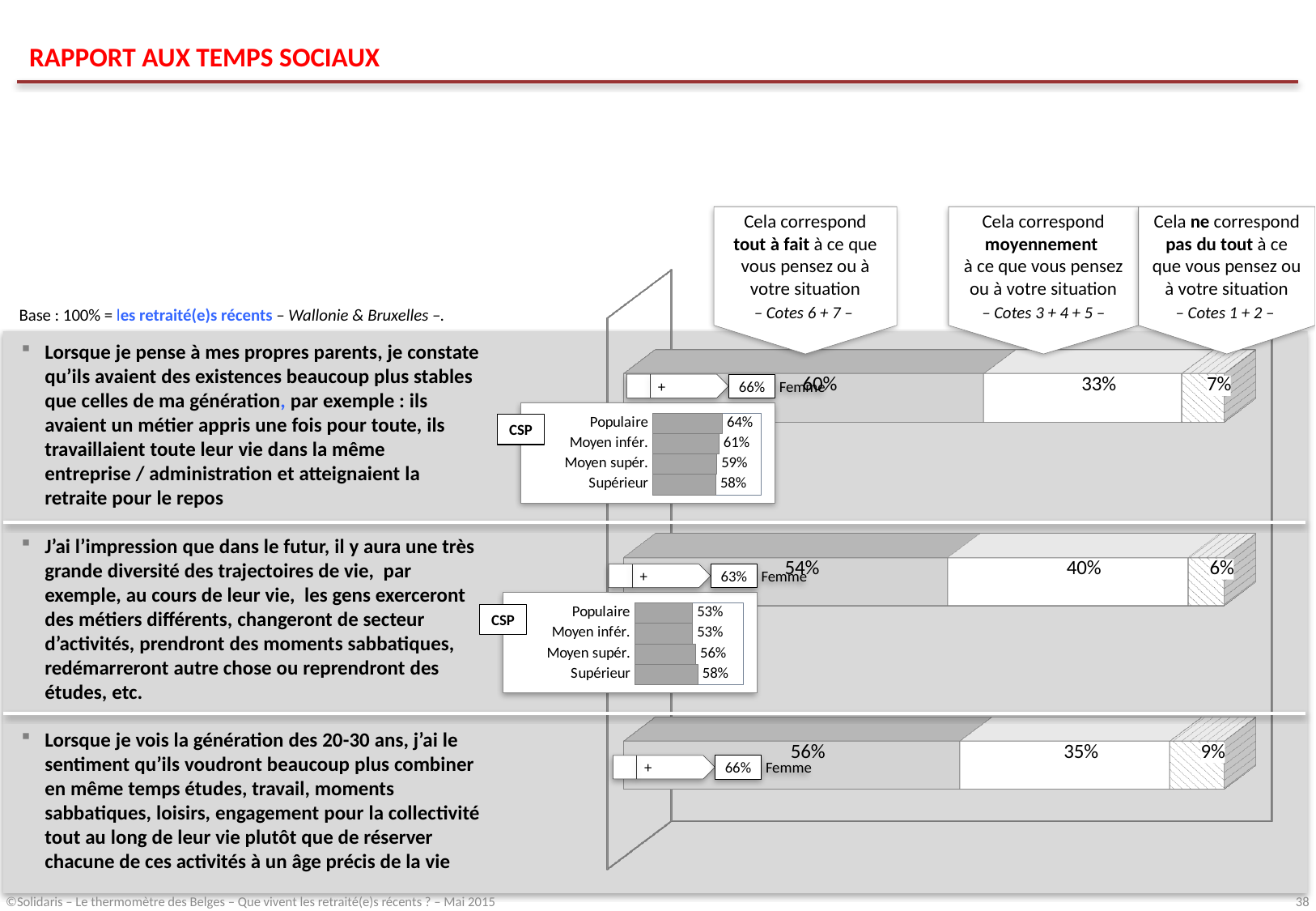
What is the 'Femme' value shown next to the bottom stacked bar (20-30 ans generation)? 66% Which of the three stacked bars has the largest 'Cela ne correspond pas du tout' share? The bottom bar (20-30 ans generation), 9% In the top stacked bar (about parents having more stable existences), what percentage corresponds to 'Cela correspond moyennement'? 33% In the middle stacked bar (about future diversity of life trajectories), what percentage corresponds to 'Cela correspond tout à fait'? 54% In the bottom stacked bar (about the 20-30 year old generation), what is the difference between the 'tout à fait' share and the 'moyennement' share? 21 percentage points In the top stacked bar (about parents having more stable existences), what percentage corresponds to 'Cela ne correspond pas du tout'? 7% In the CSP breakdown for the middle statement (future diversity of trajectories), what is the value for 'Supérieur'? 58% In the CSP breakdown for the middle statement, is the value for 'Moyen supér.' larger or smaller than the value for 'Populaire'? larger In the bottom stacked bar (about the 20-30 year old generation), what percentage corresponds to 'Cela ne correspond pas du tout'? 9% In the CSP breakdown for the top statement (parents' stable existences), what is the value for 'Populaire'? 64% In the CSP breakdown for the top statement (parents' stable existences), which category has the lowest value? Supérieur In the middle stacked bar (about future diversity of life trajectories), what percentage corresponds to 'Cela correspond moyennement'? 40%